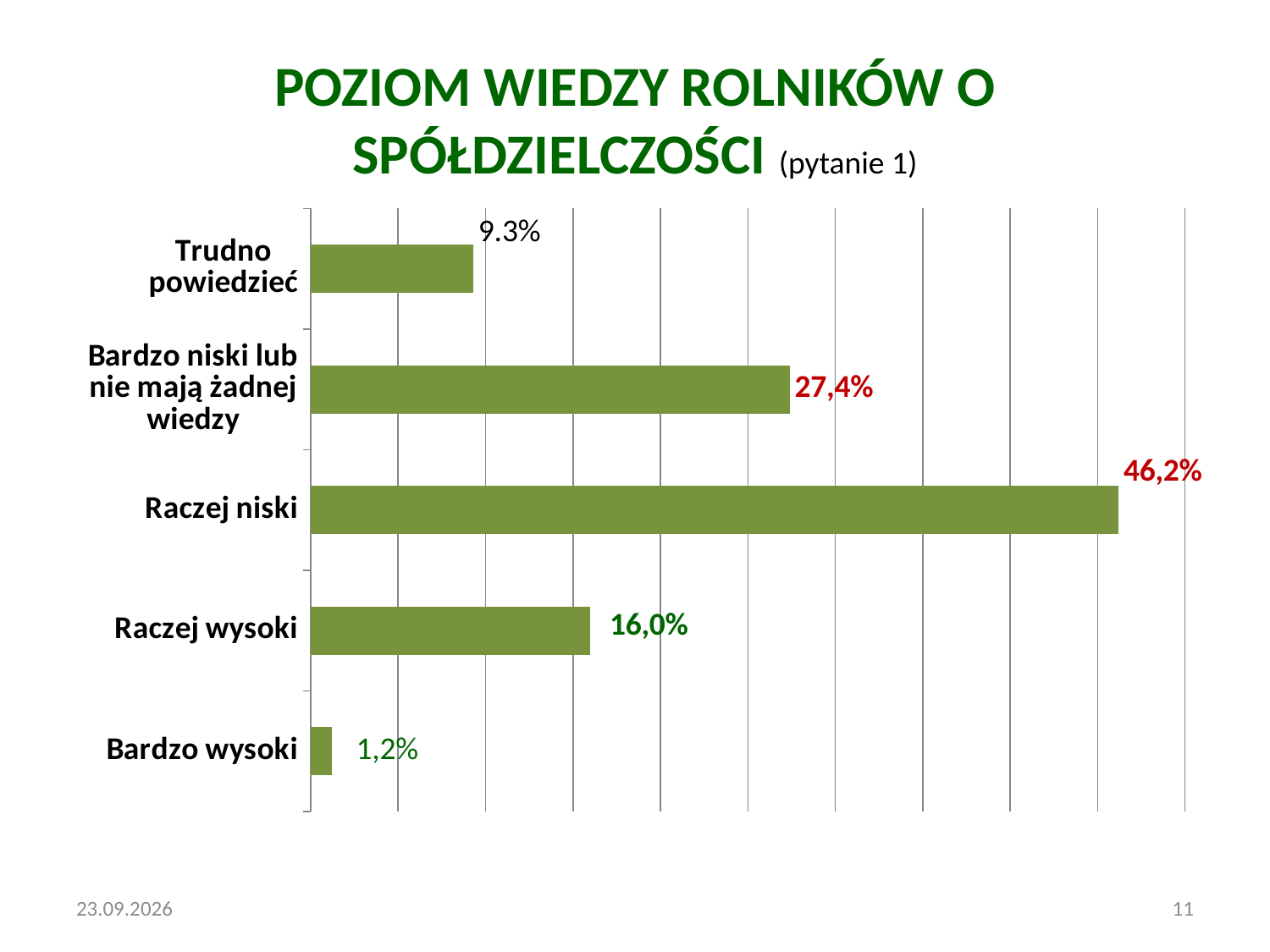
What is the title of the chart on the slide? POZIOM WIEDZY ROLNIKÓW O SPÓŁDZIELCZOŚCI (pytanie 1) How many categories are shown in the chart? 5 What is the value for "Raczej wysoki"? 16,0% What is the value for "Bardzo wysoki"? 1,2% Which category has the lowest value? Bardzo wysoki What is the difference between the values for "Raczej niski" and "Bardzo niski lub nie mają żadnej wiedzy"? 18,8% Which is larger, the value for "Raczej wysoki" or the value for "Trudno powiedzieć"? Raczej wysoki What is the value for "Bardzo niski lub nie mają żadnej wiedzy"? 27,4% What is the value for "Trudno powiedzieć"? 9.3% Which category has the highest value? Raczej niski What kind of chart is shown on the slide? Bar chart What is the value for "Raczej niski"? 46,2%